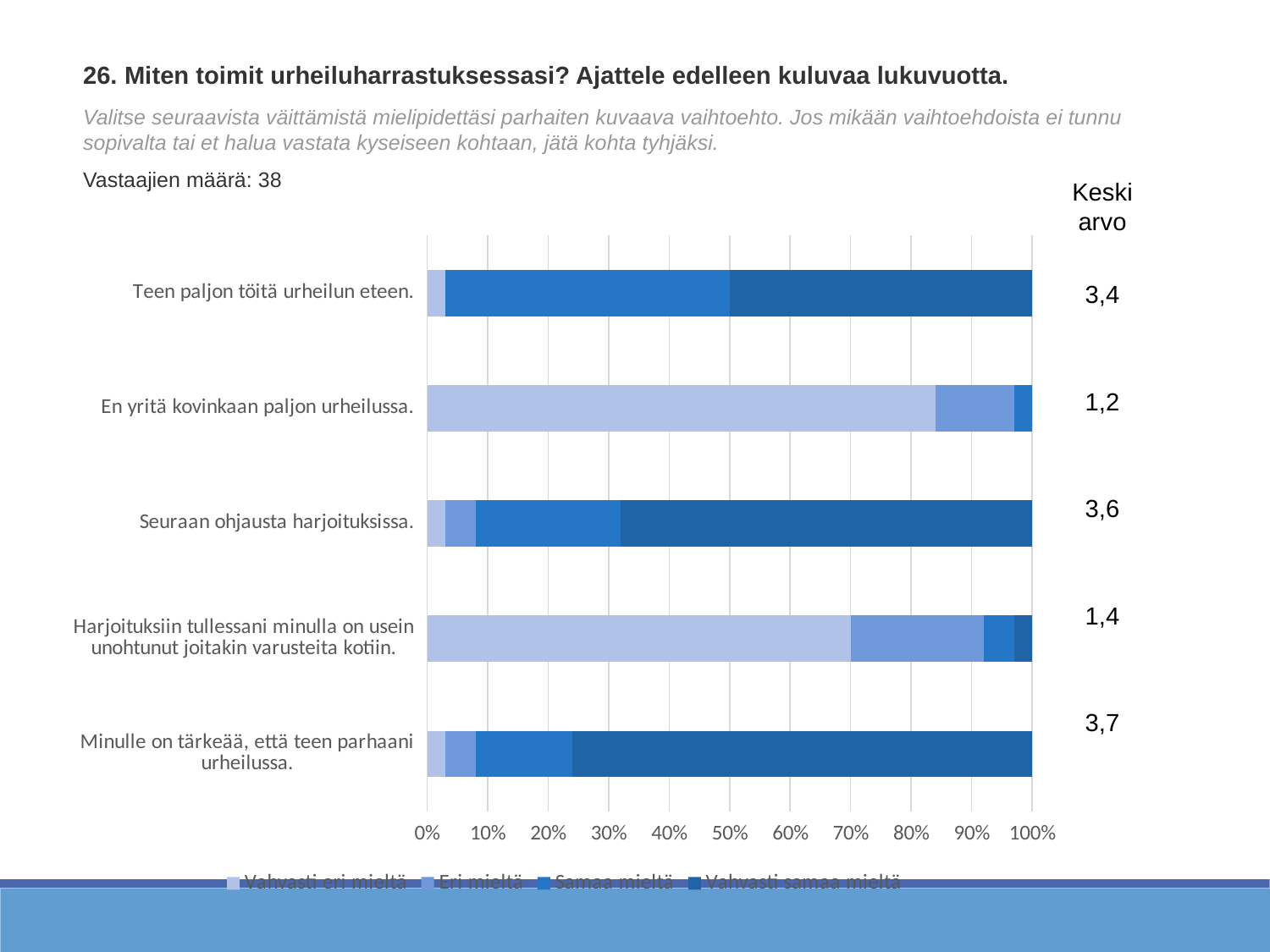
Which statement has the highest Keskiarvo (mean) value? Minulle on tärkeää, että teen parhaani urheilussa. Which has a larger Keskiarvo value: "Seuraan ohjausta harjoituksissa." or "Teen paljon töitä urheilun eteen."? Seuraan ohjausta harjoituksissa. What is the Keskiarvo (mean) value shown for "Teen paljon töitä urheilun eteen."? 3,4 What kind of chart is shown on the slide? Stacked bar chart How many statements (categories) are plotted in the chart? 5 What is the Keskiarvo (mean) value shown for "En yritä kovinkaan paljon urheilussa."? 1,2 How many series does the chart legend list? 4 How many respondents (Vastaajien määrä) are reported on the slide? 38 Which statement has the lowest Keskiarvo (mean) value? En yritä kovinkaan paljon urheilussa. Is the "Vahvasti eri mieltä" share for "En yritä kovinkaan paljon urheilussa." greater or less than 80%? greater What is the difference between the highest and lowest Keskiarvo values shown? 2,5 What is the Keskiarvo (mean) value shown for "Harjoituksiin tullessani minulla on usein unohtunut joitakin varusteita kotiin."? 1,4